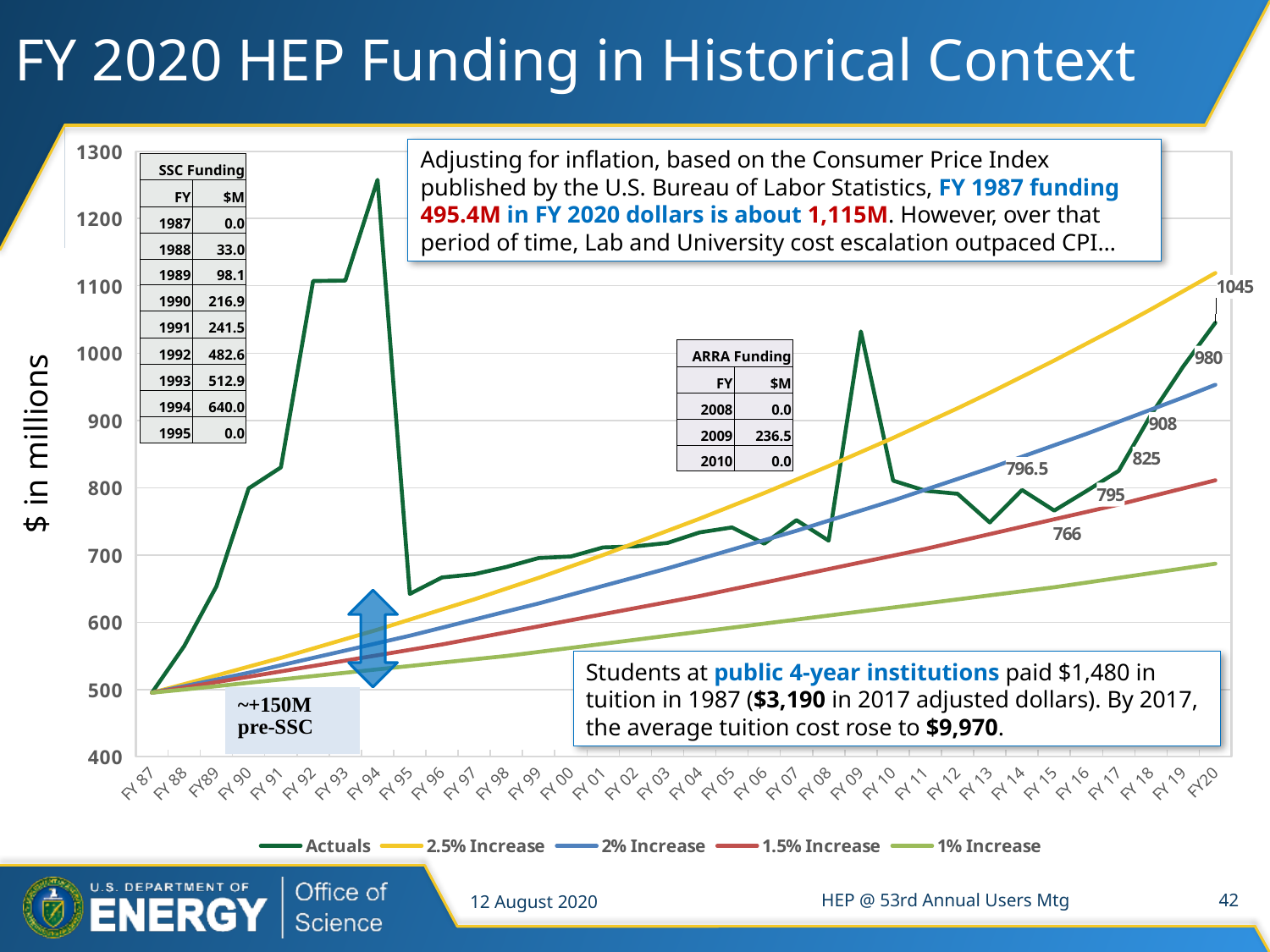
What is the difference between the Actuals values for FY20 and FY19? 65 At FY20, which is larger: the Actuals value or the 2% Increase value? Actuals What kind of chart is shown on the slide? line chart What is the Actuals value for FY20? 1045 What is the Actuals value for FY19? 980 According to the SSC Funding table, what was SSC funding in $M for 1994? 640.0 Is the Actuals value for FY 94 greater or less than 1200? greater In which fiscal year does the Actuals line reach its highest point? FY 94 Is the Actuals value for FY 95 greater or less than 700? less Does the 2.5% Increase line rise or fall from FY 87 to FY20? rise How many series does the chart legend list? 5 Is the 1% Increase value at FY20 greater or less than 700? less